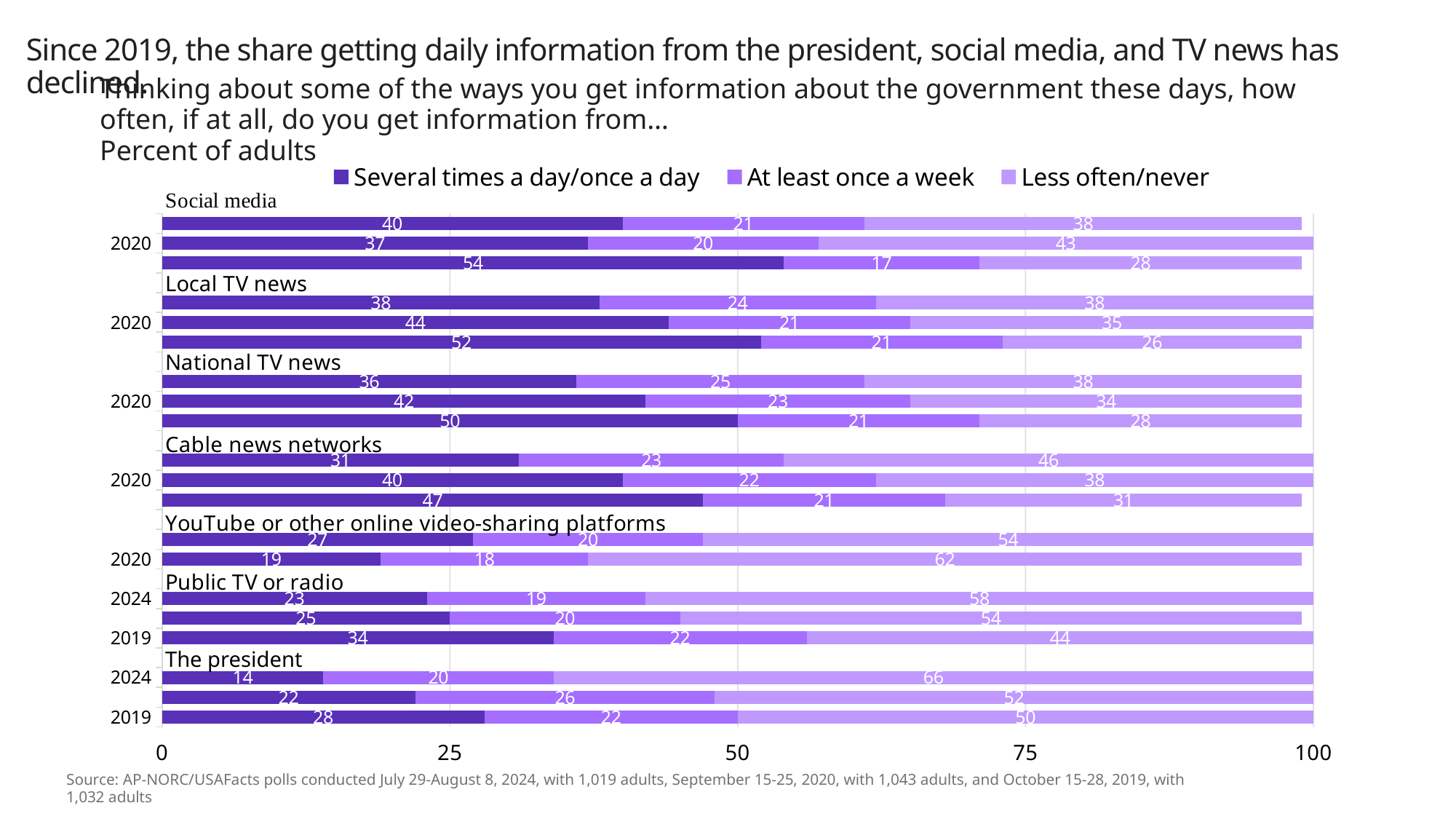
For Cable news networks in 2020, what percent get information at least once a week? 22 What kind of chart is shown on the slide? Stacked bar chart For The president in 2024, what percent get information less often/never? 66 Among the 2020 bars, which source has the highest 'Several times a day/once a day' value? Local TV news For Public TV or radio, how much larger is the 'Several times a day/once a day' value in 2019 than in 2024? 11 What are the three legend entries? Several times a day/once a day; At least once a week; Less often/never How many series does the legend list? 3 For Social media in 2020, what percent get information several times a day/once a day? 37 What is the total of the three segments in the Social media 2020 bar? 100 For Public TV or radio in 2019, what percent get information several times a day/once a day? 34 Which is larger: the 'Less often/never' value for The president in 2024 or for YouTube or other online video-sharing platforms in 2020? The president in 2024 Which bar on the chart has the smallest 'Several times a day/once a day' value? The president, 2024